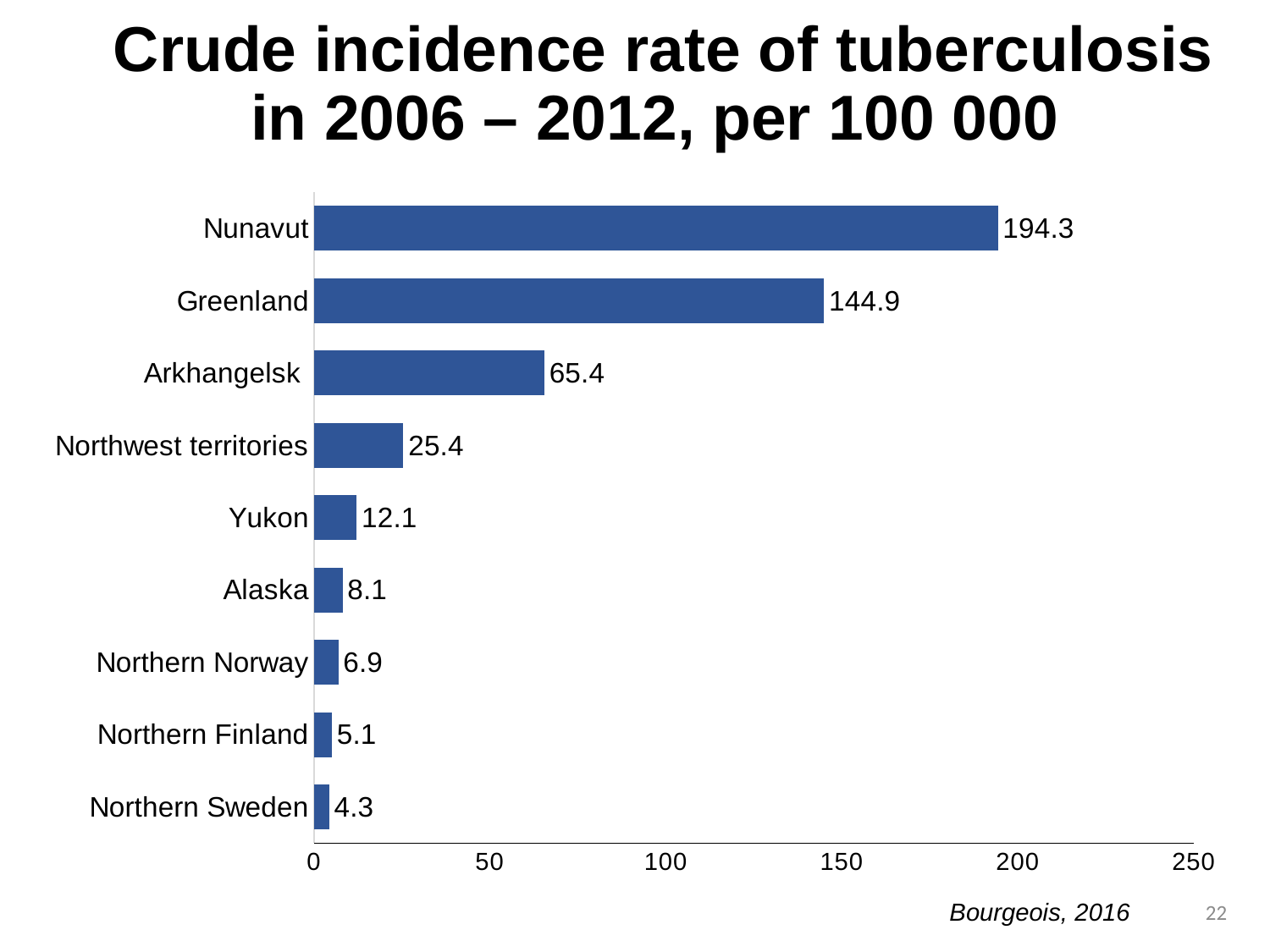
What is the title of the chart? Crude incidence rate of tuberculosis in 2006 – 2012, per 100 000 Which has a higher crude incidence rate, Alaska or Northern Finland? Alaska How many regions are shown in the chart? 9 Is the value for Greenland greater or less than 150? less What is the crude incidence rate of tuberculosis for Arkhangelsk? 65.4 What is the difference between the rates for Nunavut and Greenland? 49.4 Which region has the highest crude incidence rate of tuberculosis? Nunavut What is the crude incidence rate of tuberculosis for Northern Norway? 6.9 Which region has the lowest crude incidence rate of tuberculosis? Northern Sweden What is the difference between the rates for Northwest territories and Yukon? 13.3 What kind of chart is shown on the slide? Bar chart What is the crude incidence rate of tuberculosis for Nunavut? 194.3